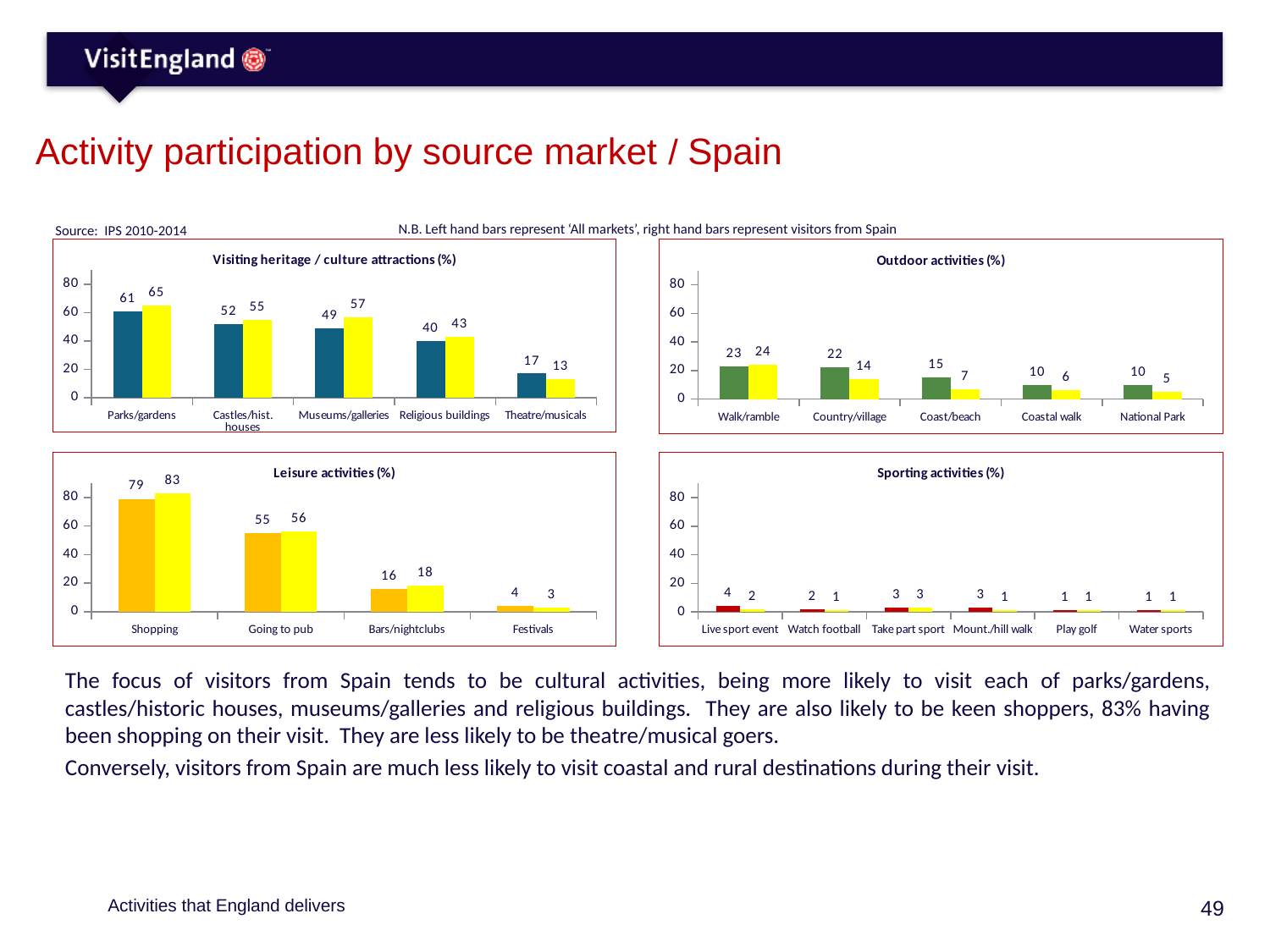
In the 'Sporting activities (%)' chart, how many categories are shown on the x axis? 6 In the 'Visiting heritage / culture attractions (%)' chart, what is the difference between the two bars for Parks/gardens? 4 In the 'Outdoor activities (%)' chart, which category has the highest right-hand (Spain) bar? Walk/ramble In the 'Visiting heritage / culture attractions (%)' chart, which category has the lowest values? Theatre/musicals In the 'Leisure activities (%)' chart, what is the value of the right-hand (Spain) bar for Shopping? 83 In the 'Sporting activities (%)' chart, what is the value of the left-hand (All markets) bar for Live sport event? 4 In the 'Outdoor activities (%)' chart, how many categories are shown on the x axis? 5 In the 'Outdoor activities (%)' chart, what is the value of the left-hand (All markets) bar for Country/village? 22 In the 'Leisure activities (%)' chart, is the left-hand bar for Going to pub larger or smaller than the right-hand bar for Bars/nightclubs? larger In the 'Leisure activities (%)' chart, do the values rise or fall moving from left to right along the x axis? fall What type of chart is the 'Sporting activities (%)' chart? bar chart In the 'Visiting heritage / culture attractions (%)' chart, what is the value of the right-hand (Spain) bar for Museums/galleries? 57